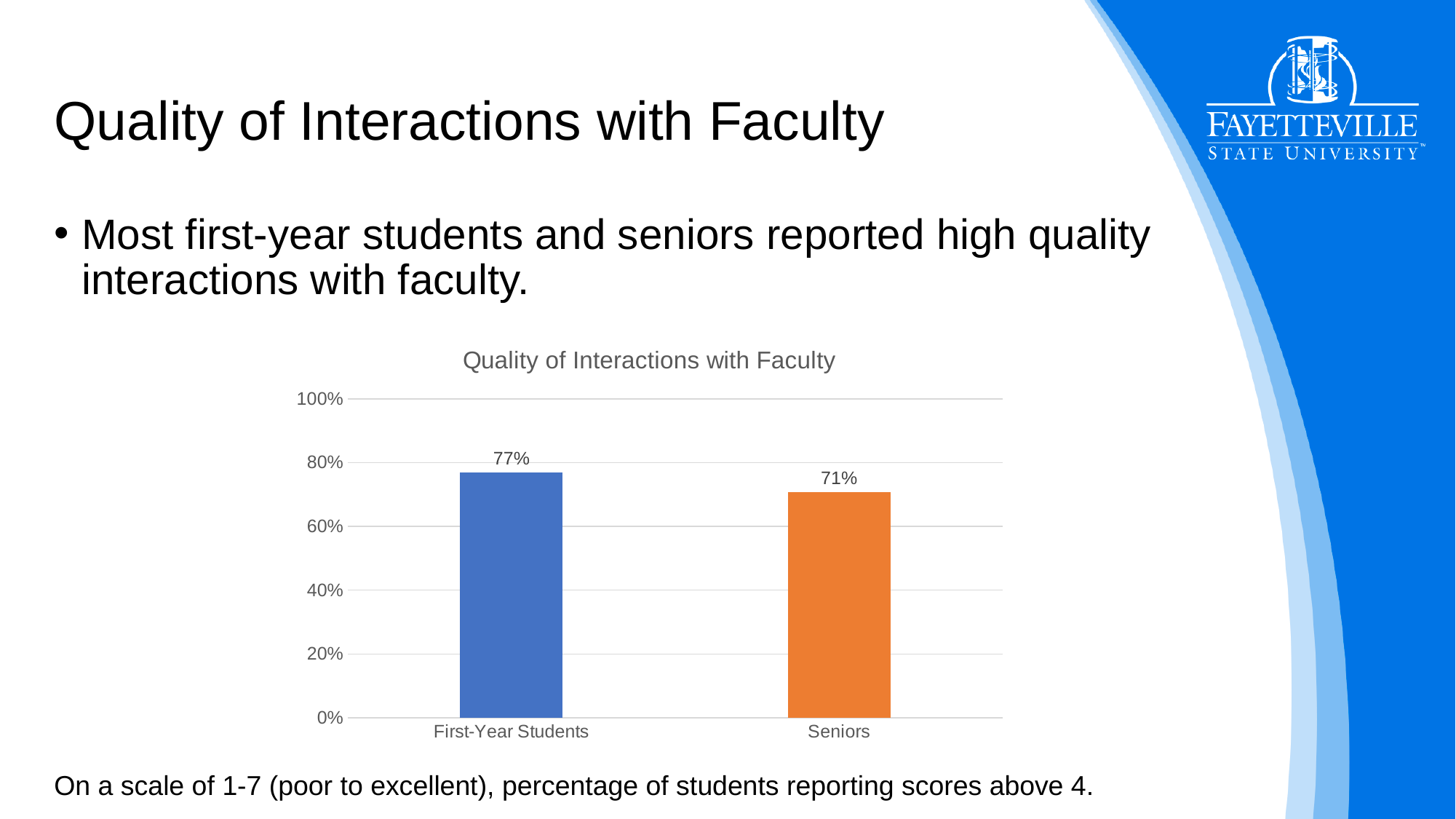
How many categories are shown on the x axis? 2 Which category has the highest value? First-Year Students What is the value for First-Year Students? 77% What is the title of the chart? Quality of Interactions with Faculty Is the value for Seniors greater or less than 80%? less What is the value for Seniors? 71% Is the value for First-Year Students greater or less than 60%? greater Which is larger, the value for First-Year Students or the value for Seniors? First-Year Students Which category has the lowest value? Seniors What is the difference between the values for First-Year Students and Seniors? 6% What kind of chart is shown on the slide? bar chart What colour is the bar for Seniors? orange